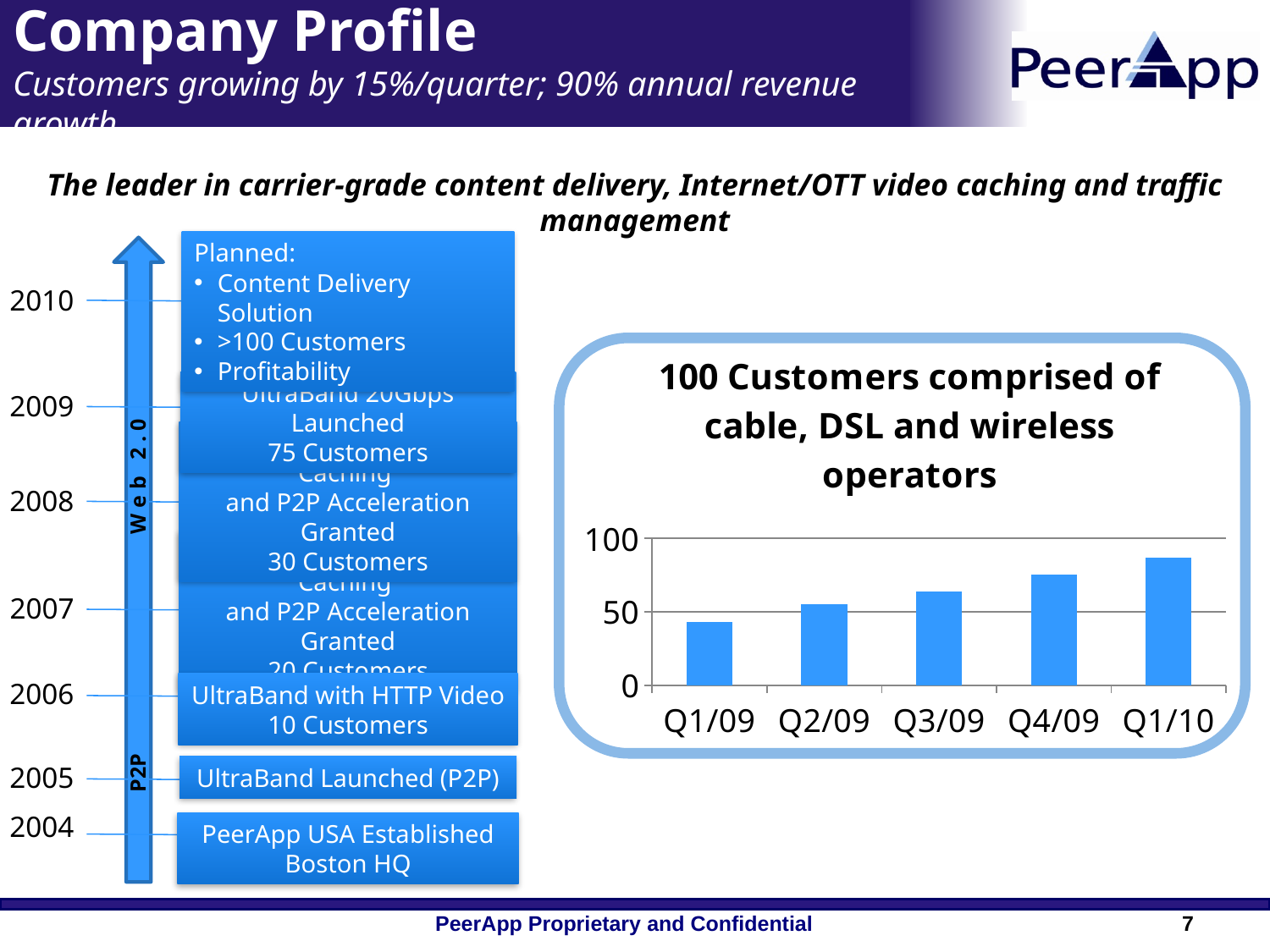
What is the highest tick value shown on the chart's vertical axis? 100 Do the bar values rise or fall from Q1/09 to Q1/10? rise Is the value for Q4/09 greater or less than 50? greater Which quarter has the lowest bar in the chart? Q1/09 Which is larger, the bar for Q2/09 or the bar for Q4/09? Q4/09 Is the value for Q1/10 greater or less than 100? less How many quarters are plotted on the bar chart? 5 What kind of chart is shown on the right side of the slide? bar chart Which is larger, the bar for Q1/10 or the bar for Q1/09? Q1/10 Is the value for Q3/09 greater or less than 50? greater Which quarter has the highest bar in the chart? Q1/10